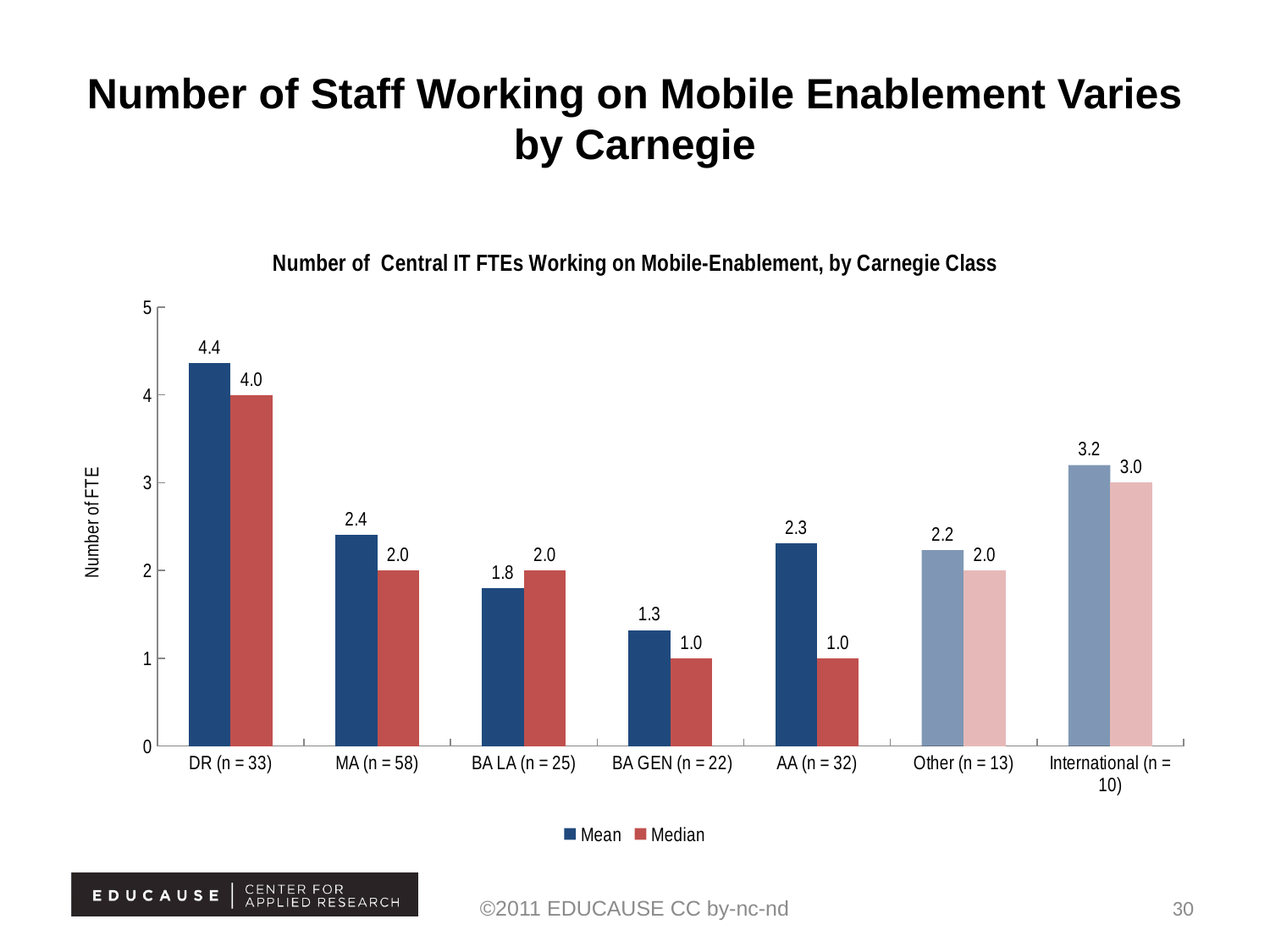
Which Carnegie class has the lowest Mean number of FTEs? BA GEN (n = 22) Which is larger, the Mean for MA (n = 58) or the Mean for AA (n = 32)? MA (n = 58) What is the Median number of FTEs for International (n = 10)? 3.0 Which Carnegie class has the highest Mean number of FTEs? DR (n = 33) Is the Mean value for International (n = 10) greater or less than 3? greater What kind of chart is shown on the slide? Bar chart What is the difference between the Mean and Median values for AA (n = 32)? 1.3 How many Carnegie class categories are shown on the x axis? 7 What is the label of the y axis? Number of FTE How many series does the legend list? 2 What is the Mean value for BA GEN (n = 22)? 1.3 What is the Mean number of FTEs for DR (n = 33)? 4.4